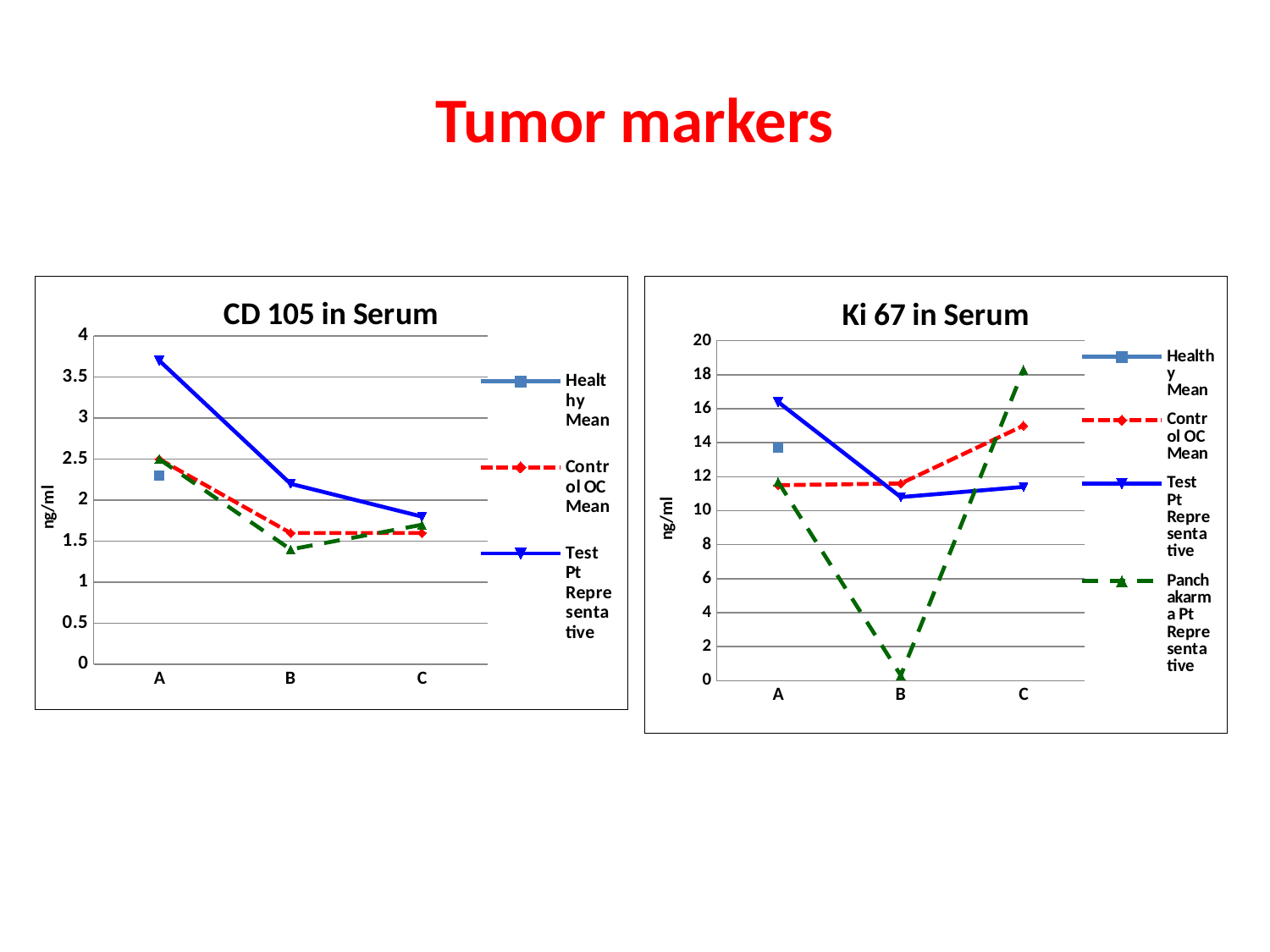
In the "Ki 67 in Serum" chart, is the Panchakarma Pt Representative value at C greater or less than 16? greater What is the y-axis label of the "Ki 67 in Serum" chart? ng/ml In the "Ki 67 in Serum" chart, at category A, which is larger: Test Pt Representative or Control OC Mean? Test Pt Representative How many categories are shown on the x axis of the "Ki 67 in Serum" chart? 3 What type of chart is the "CD 105 in Serum" chart? line chart How many series does the legend of the "CD 105 in Serum" chart list? 3 In the "CD 105 in Serum" chart, is the Test Pt Representative value at A greater or less than 3.5? greater In the "Ki 67 in Serum" chart, is the Panchakarma Pt Representative value at B greater or less than 2? less In the "CD 105 in Serum" chart, does the Test Pt Representative line rise or fall from A to C? fall In the "Ki 67 in Serum" chart, at which category is the Panchakarma Pt Representative value highest? C How many series does the legend of the "Ki 67 in Serum" chart list? 4